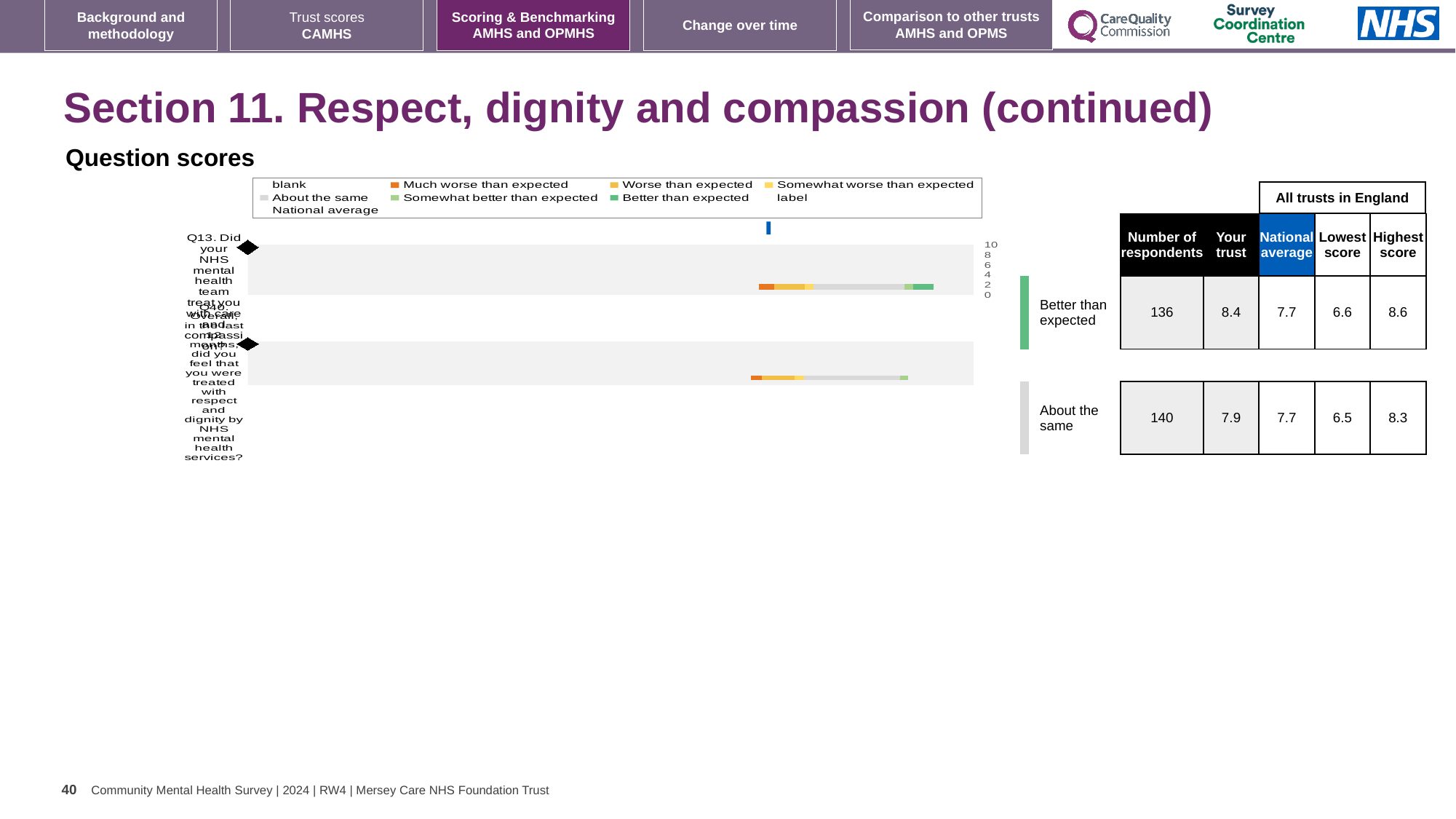
What kind of chart is shown under "Question scores"? bar chart What is the highest score across all trusts in England for Q13? 8.6 Which question has the higher "Your trust" score, Q13 or Q10? Q13 What is the "Your trust" score for Q13? 8.4 Which benchmark category is Q10 (treated with respect and dignity) placed in? About the same How many questions (categories) are plotted in the Question scores chart? 2 How many entries does the legend of the Question scores chart list? 9 What is the difference between the "Your trust" score and the national average for Q13? 0.7 Which question had more respondents, Q13 or Q10? Q10 Which benchmark category is Q13 (treated with care and compassion) placed in? Better than expected How many respondents answered Q10? 140 What is the "Your trust" score for Q10? 7.9